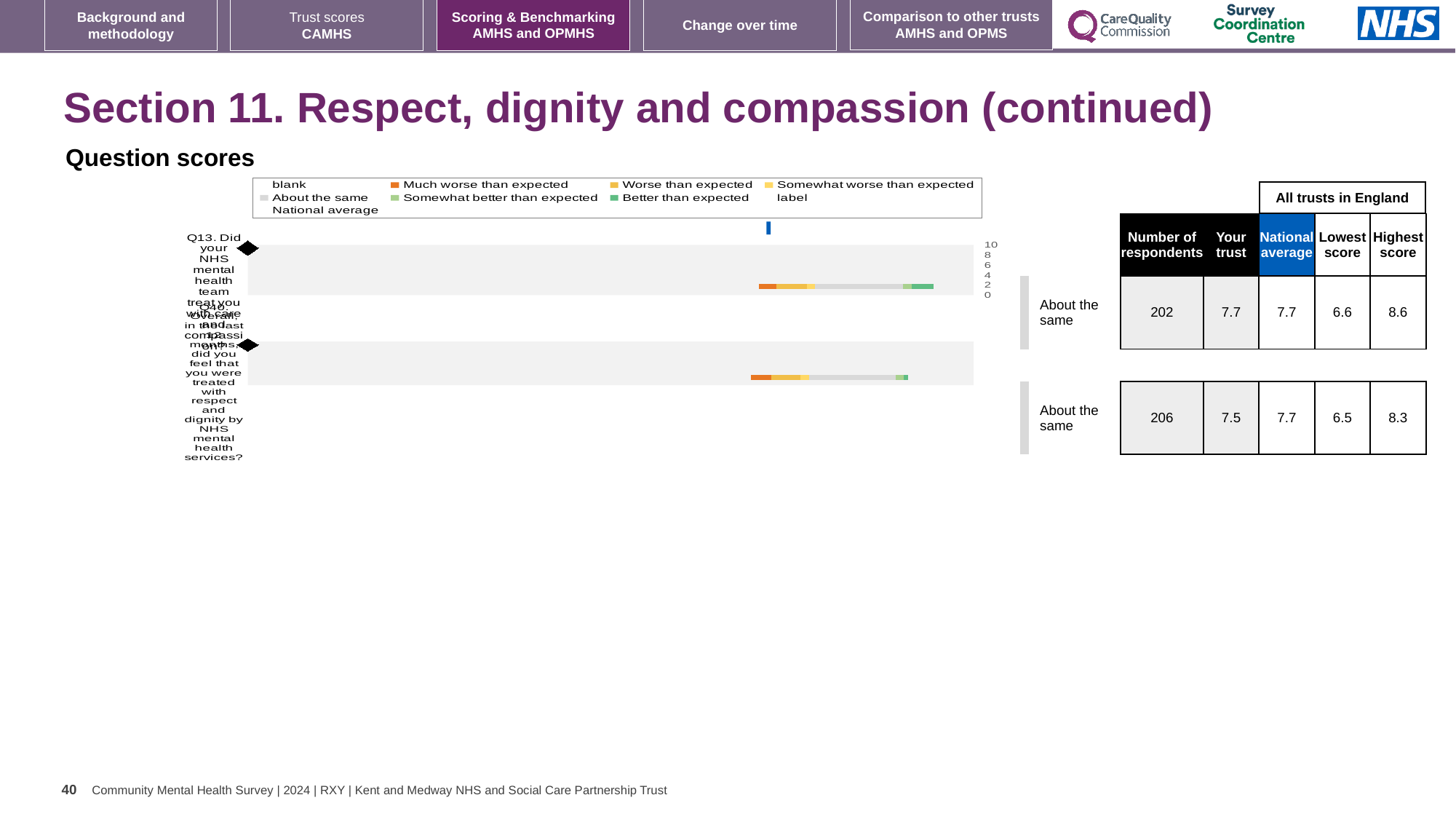
What kind of chart is shown under 'Question scores'? bar chart In the table, what is the number of respondents for the first (top) question row? 202 Which question row has the larger highest score in the table, the first (top) or the second (bottom)? first (top) How many more respondents does the second (bottom) question row have than the first (top)? 4 How many questions (categories) are plotted in the bar chart? 2 In the table, what is the national average for the first (top) question row? 7.7 What benchmark category is shown beside both question rows? About the same What is the difference between the highest score and the lowest score for the first (top) question row? 2.0 In the table, what is the 'Your trust' score for the second (bottom) question row? 7.5 How many entries does the chart legend list? 9 In the table, what is the highest score for the second (bottom) question row? 8.3 In the table, what is the lowest score for the first (top) question row? 6.6